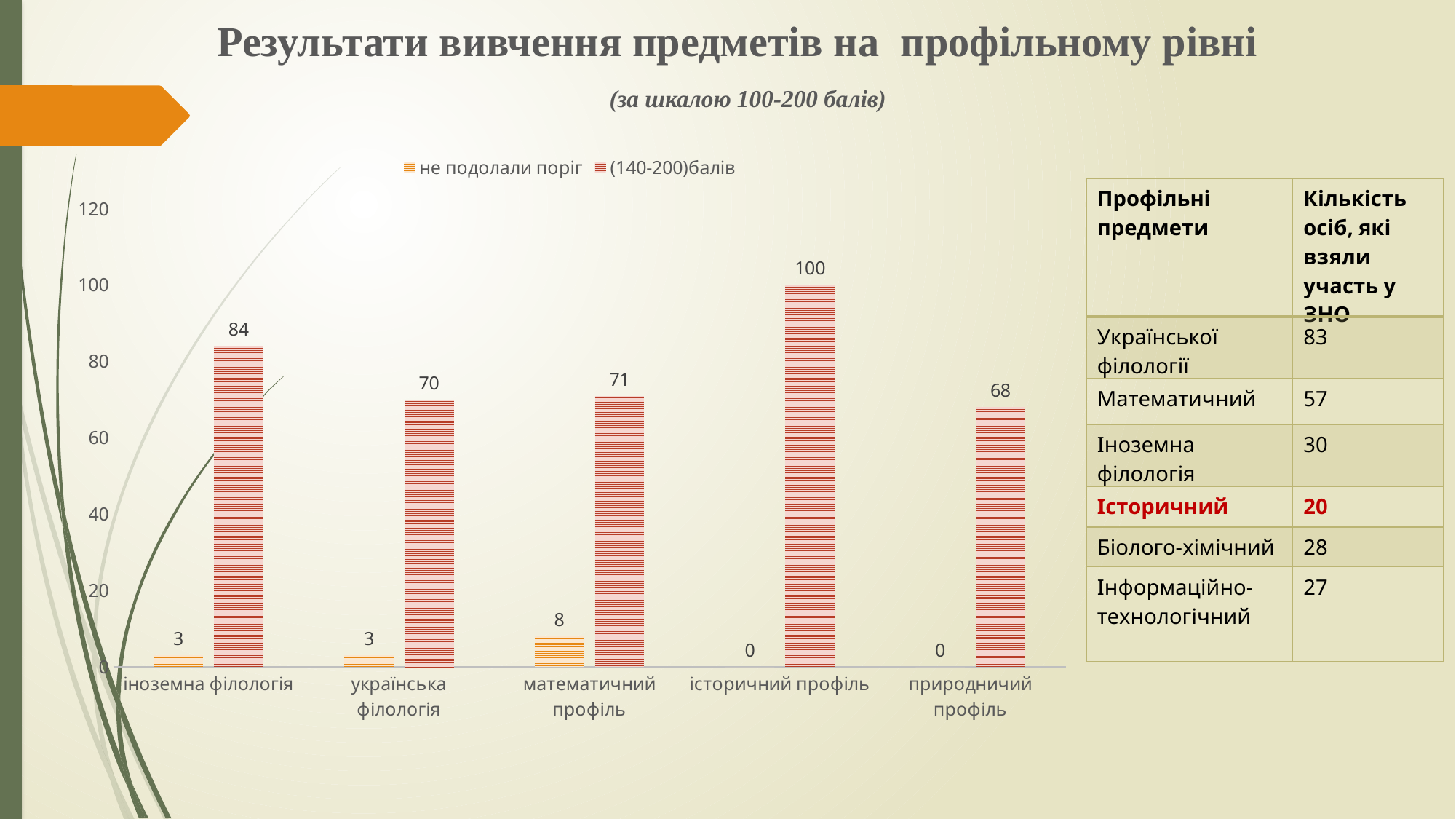
What is the value of the "не подолали поріг" series for математичний профіль? 8 What is the difference between the "(140-200)балів" values for історичний профіль and іноземна філологія? 16 How many series does the chart legend list? 2 Which category has the lowest value in the "(140-200)балів" series? природничий профіль How many categories are shown on the x axis of the chart? 5 What is the total of the two series values for математичний профіль? 79 What is the value of the "(140-200)балів" series for історичний профіль? 100 Is the "(140-200)балів" value for математичний профіль greater or less than 60? greater What kind of chart is shown on the slide? bar chart What is the value of the "(140-200)балів" series for природничий профіль? 68 Which category has the highest value in the "(140-200)балів" series? історичний профіль Which is larger in the "(140-200)балів" series: іноземна філологія or українська філологія? іноземна філологія